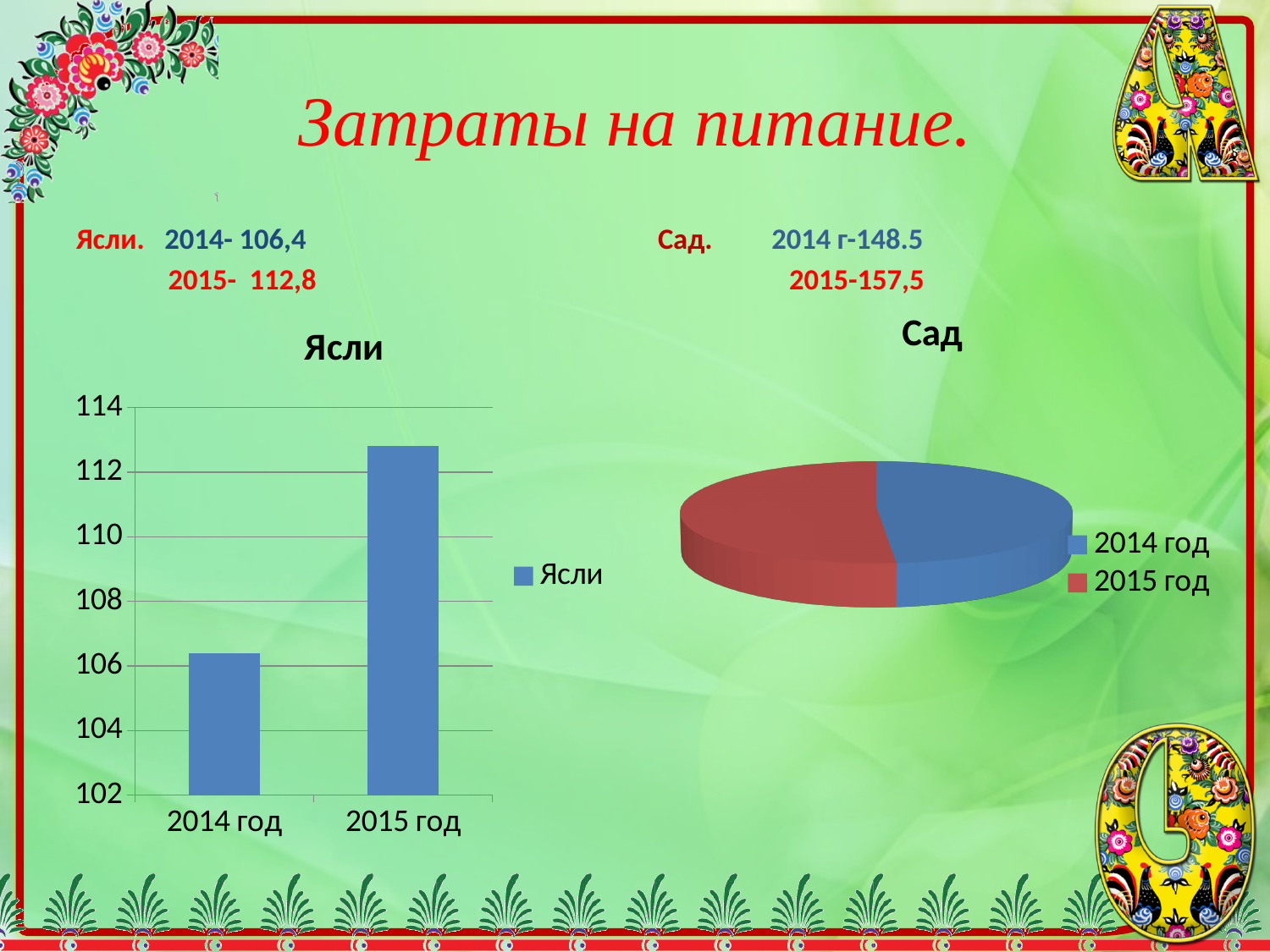
What kind of chart is the chart titled "Сад"? pie chart In the "Сад" pie chart, which colour represents 2015 год? red In the "Ясли" bar chart, which year has the higher bar? 2015 год How many entries does the legend of the "Сад" pie chart list? 2 In the "Ясли" bar chart, is the value for 2015 год greater or less than 112? greater In the "Ясли" bar chart, how many bars are plotted? 2 In the "Ясли" bar chart, do the values rise or fall from 2014 год to 2015 год? rise According to the text on the slide, what is the "Сад" value for 2014? 148.5 What kind of chart is the chart titled "Ясли"? bar chart In the "Ясли" bar chart, is the value for 2014 год greater or less than 108? less According to the text on the slide, what is the "Ясли" value for 2015? 112,8 In the "Ясли" bar chart, which year has the lower bar? 2014 год